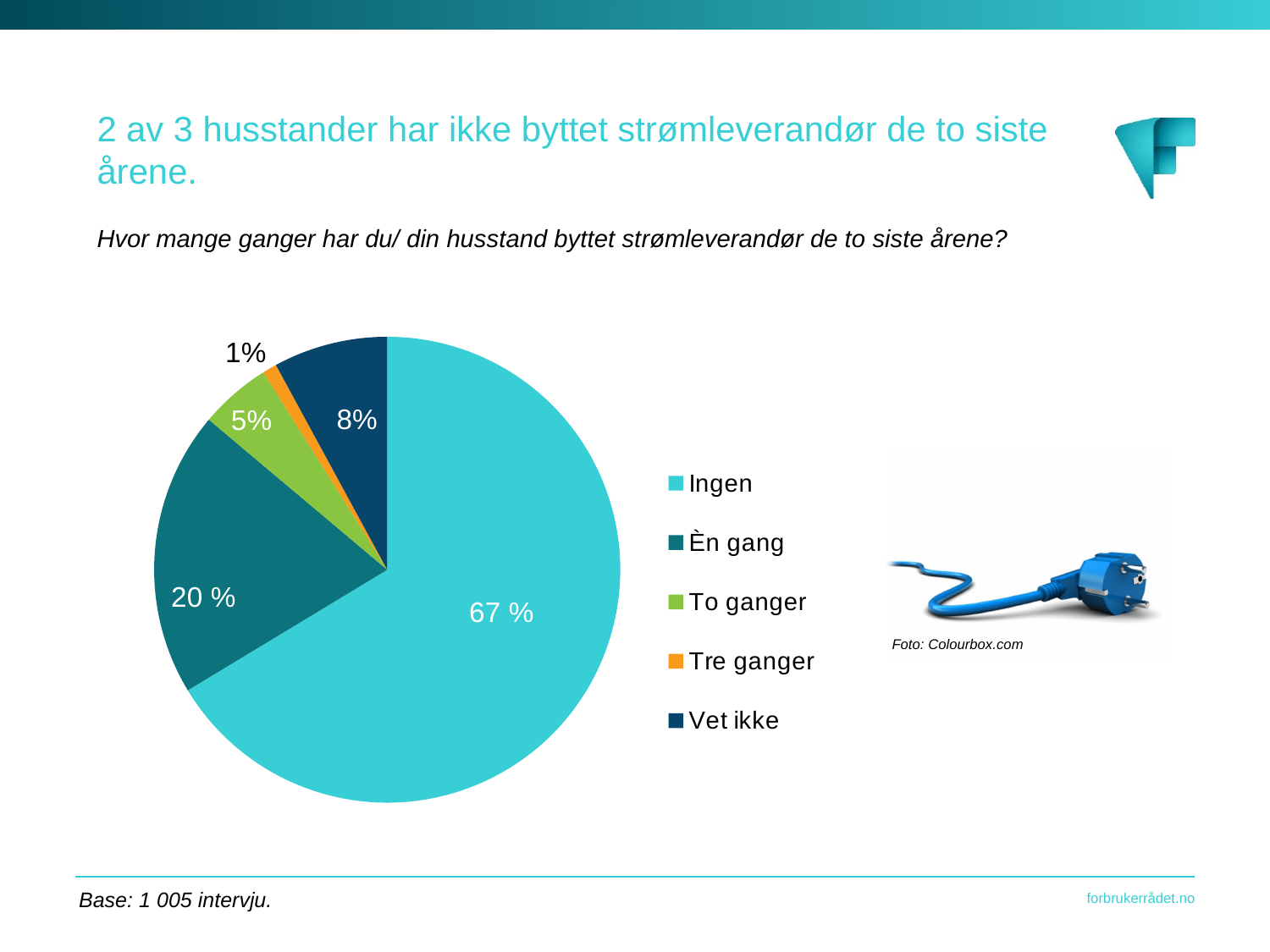
Which is larger, the slice for "Vet ikke" or the slice for "To ganger"? Vet ikke How many categories does the pie chart show? 5 Which legend entry is shown in orange? Tre ganger What is the difference in percentage points between "Ingen" and "Èn gang"? 47 Which category has the smallest slice of the pie? Tre ganger What share of the pie does "Tre ganger" represent? 1% Which category has the largest slice of the pie? Ingen What share of the pie does "Èn gang" represent? 20 % What kind of chart is shown on the slide? Pie chart What share of the pie does "Vet ikke" represent? 8% What share of the pie does "Ingen" represent? 67 % What share of the pie does "To ganger" represent? 5%